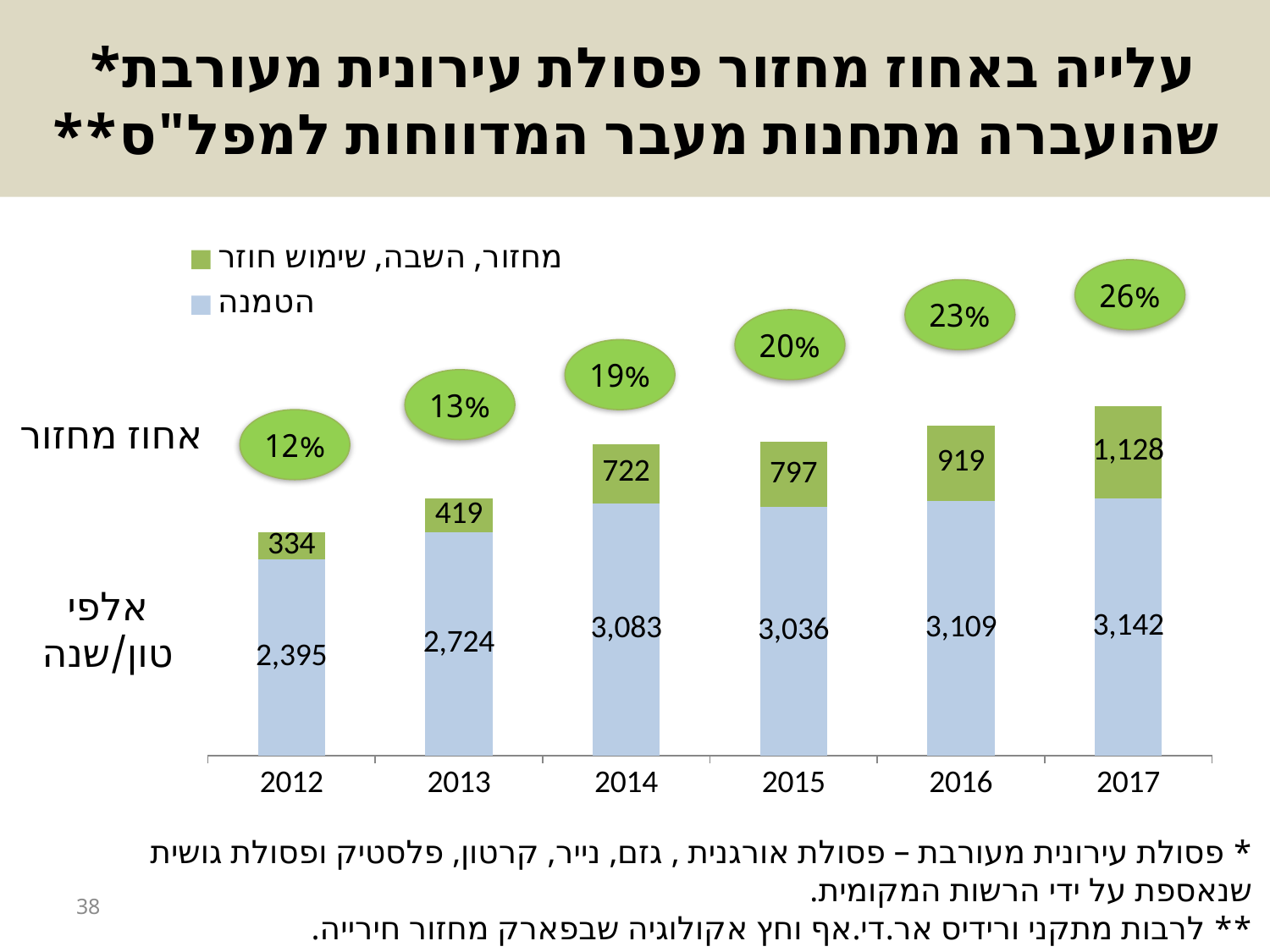
Which year has the lowest value for הטמנה? 2012 Which is larger, the הטמנה value for 2014 or for 2015? 2014 How many series does the legend list? 2 How many years are shown on the x axis? 6 What recycling percentage is shown in the bubble above the 2014 bar? 19% What kind of chart is shown on the slide? Stacked bar chart Which year has the highest value for מחזור, השבה, שימוש חוזר? 2017 What is the value of מחזור, השבה, שימוש חוזר (recycling, recovery, reuse) for 2017? 1,128 What is the total of the stacked bar for 2017? 4,270 What is the value of הטמנה (landfill) for 2012? 2,395 What is the difference between the מחזור, השבה, שימוש חוזר values for 2017 and 2012? 794 Do the מחזור, השבה, שימוש חוזר values rise or fall from 2012 to 2017? Rise